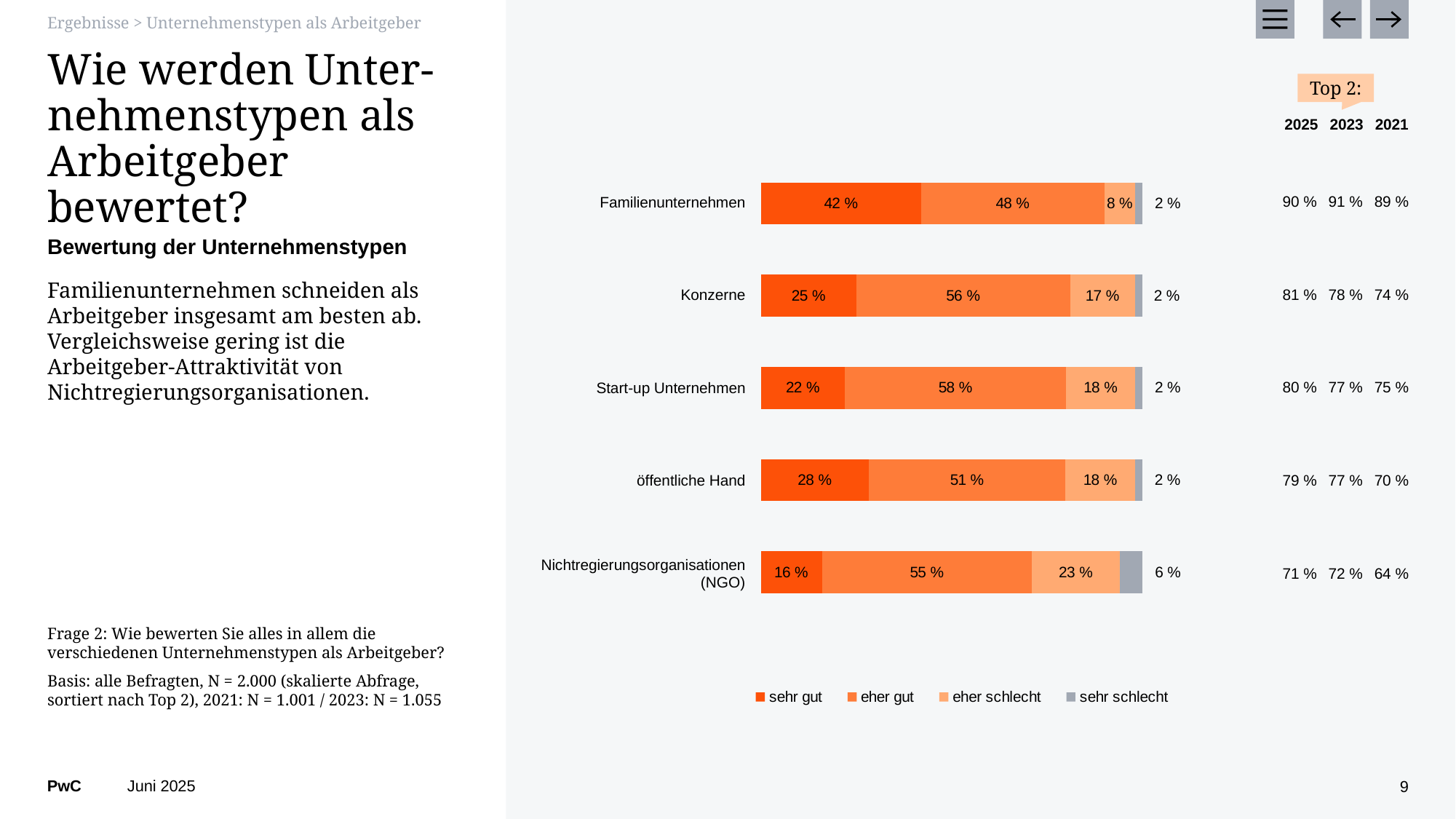
Which has a larger 'sehr schlecht' value, Nichtregierungsorganisationen (NGO) or öffentliche Hand? Nichtregierungsorganisationen (NGO) How many company types (categories) are shown in the chart? 5 What is the 'eher gut' value for Start-up Unternehmen? 58 % What is the 'eher schlecht' value for Nichtregierungsorganisationen (NGO)? 23 % What is the difference between the 'sehr gut' values for Familienunternehmen and Konzerne? 17 % Which company type has the lowest 'sehr gut' value? Nichtregierungsorganisationen (NGO) What is the combined 'sehr gut' and 'eher gut' (Top 2) value for Konzerne in 2025? 81 % Which legend entry is shown in grey? sehr schlecht Which company type has the highest 'sehr gut' value? Familienunternehmen What type of chart is shown on the slide? stacked bar chart What is the 'sehr gut' value for Familienunternehmen? 42 % How many series does the legend list? 4